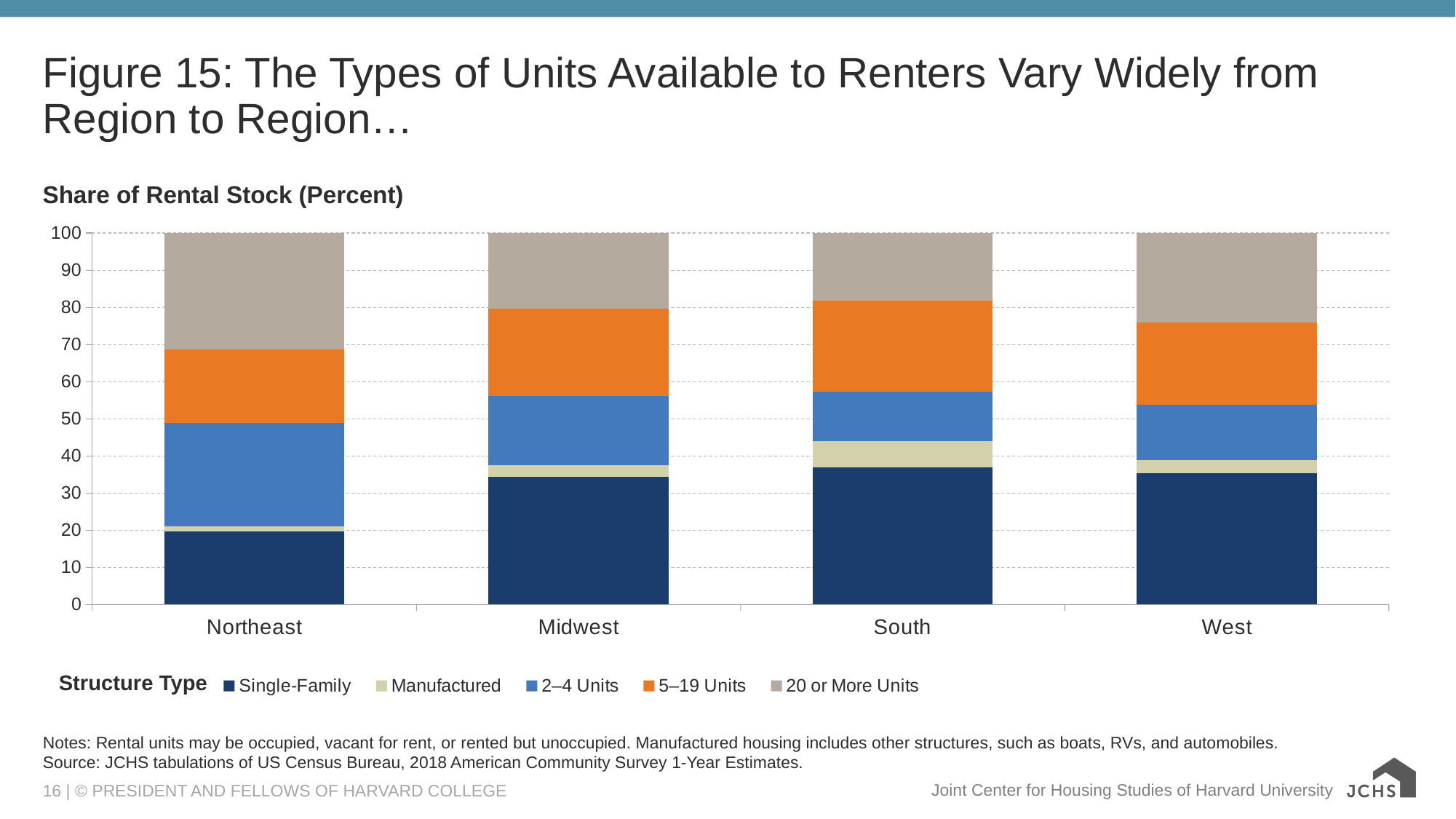
Which region has the largest Manufactured share? South How many regions are shown on the x axis of the chart? 4 Which region has a larger share of 20 or More Units, the Northeast or the West? Northeast Which region has the smallest Single-Family share of rental stock? Northeast How many structure types does the legend list? 5 Which region has the largest share of 20 or More Units? Northeast Is the Single-Family share for the South greater or less than 30? greater Is the Single-Family share for the Northeast greater or less than 30? less Which region has the largest 2–4 Units share? Northeast What is the axis label shown above the chart? Share of Rental Stock (Percent) What kind of chart is shown on the slide? Stacked bar chart What is the total height of the stacked bar for the Midwest? 100